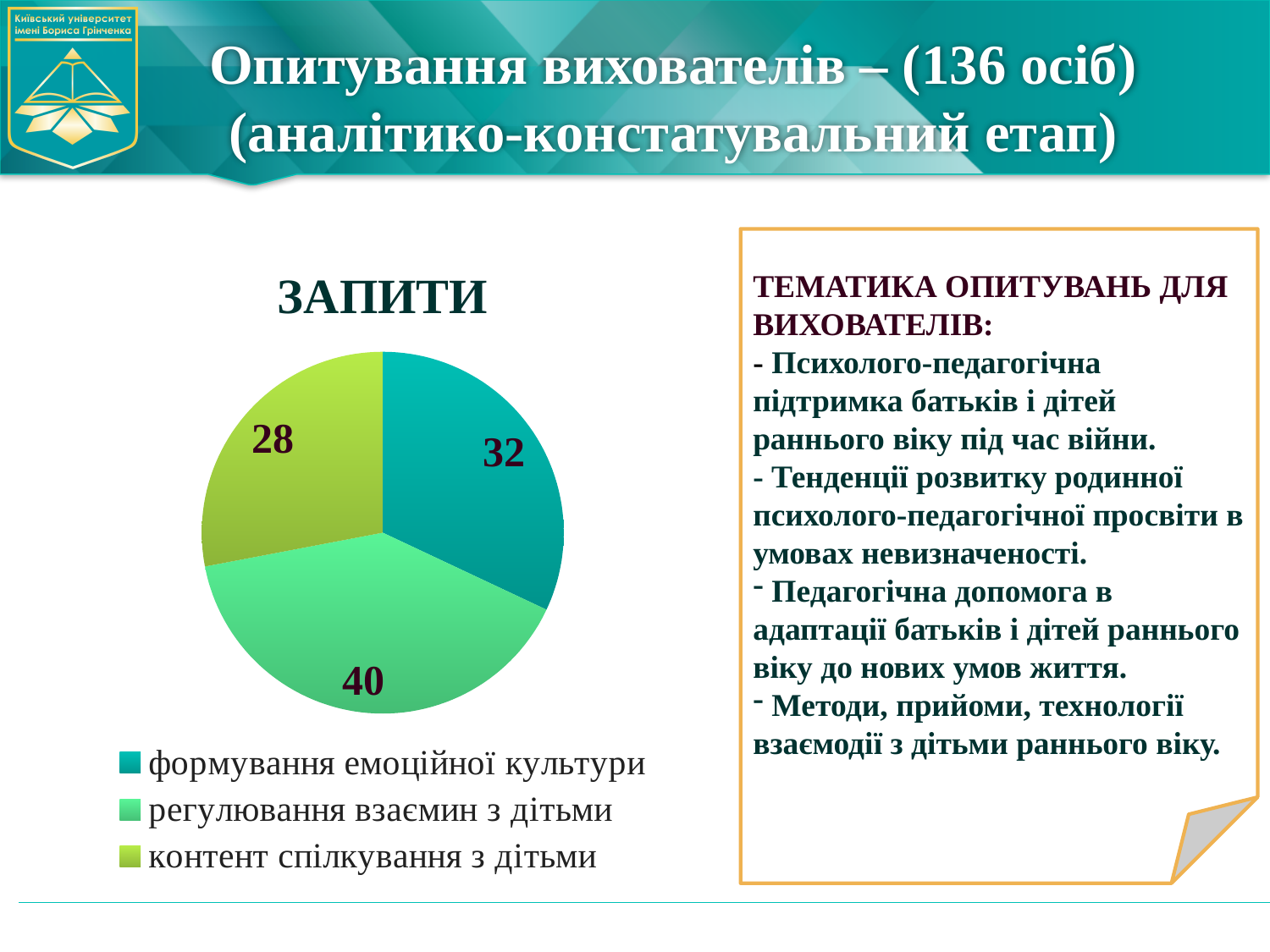
What is the difference between the values for 'регулювання взаємин з дітьми' and 'контент спілкування з дітьми'? 12 What share of the pie does 'регулювання взаємин з дітьми' represent? 40% How many slices does the pie chart have? 3 What type of chart is shown on the slide? pie chart What is the value for 'формування емоційної культури'? 32 Which is larger: the value for 'формування емоційної культури' or for 'контент спілкування з дітьми'? формування емоційної культури What is the value for 'контент спілкування з дітьми'? 28 How many entries does the chart legend list? 3 Which category has the largest slice of the pie? регулювання взаємин з дітьми Which category has the smallest slice of the pie? контент спілкування з дітьми What is the title of the chart? ЗАПИТИ What is the value for 'регулювання взаємин з дітьми'? 40